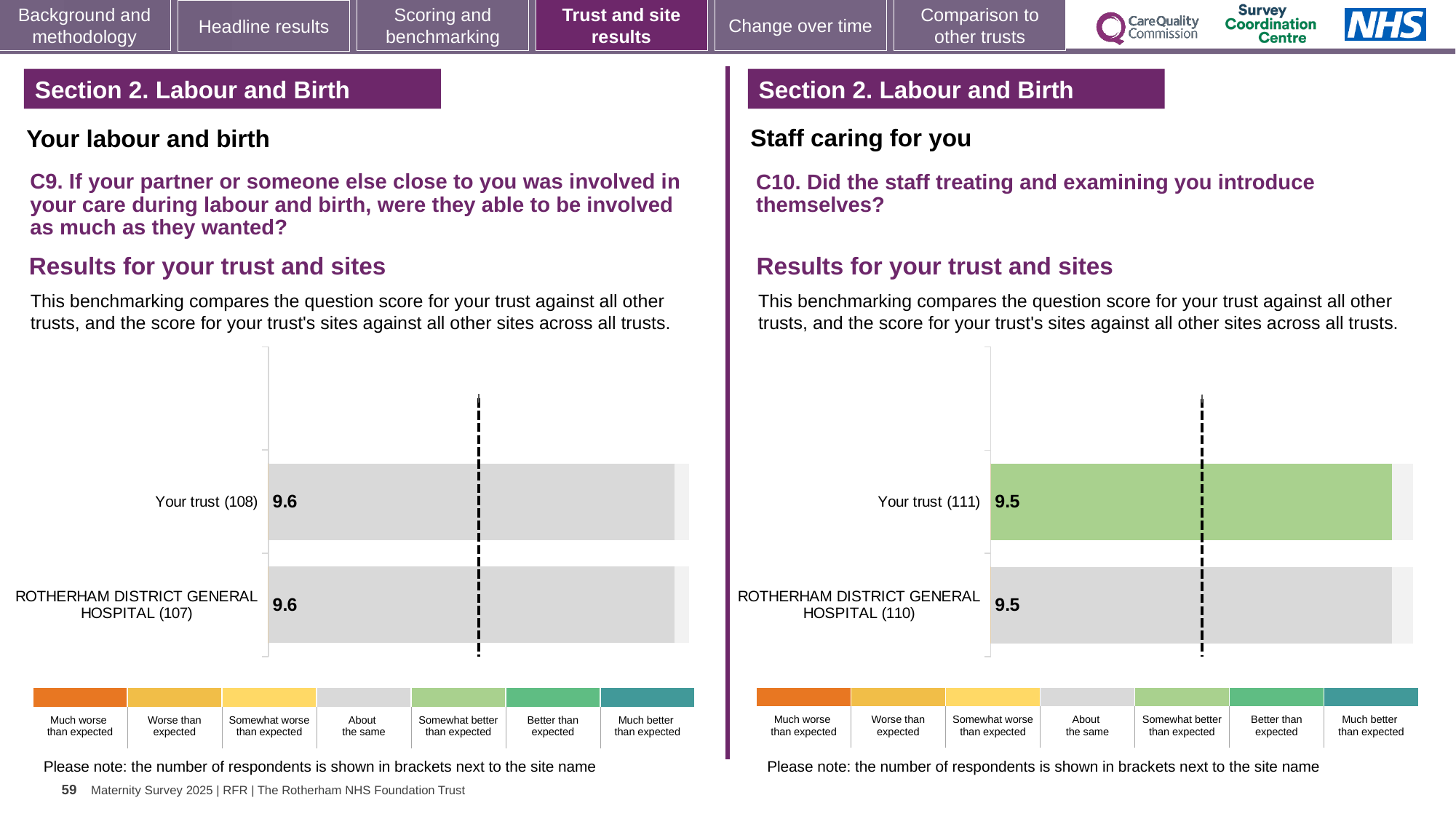
What kind of chart is used in the right chart (C10)? Bar chart How many bars are plotted in the right chart (C10)? 2 In the right chart (C10), which benchmark category does the green colour of the Your trust bar correspond to in the legend? Somewhat better than expected In the left chart (C9), what is the difference between the Your trust score and the ROTHERHAM DISTRICT GENERAL HOSPITAL score? 0.0 In the right chart (C10), how many respondents are shown in brackets for ROTHERHAM DISTRICT GENERAL HOSPITAL? 110 In the left chart (C9), what is the score for ROTHERHAM DISTRICT GENERAL HOSPITAL? 9.6 In the right chart (C10), what is the score for ROTHERHAM DISTRICT GENERAL HOSPITAL? 9.5 In the right chart (C10), what is the difference between the Your trust score and the ROTHERHAM DISTRICT GENERAL HOSPITAL score? 0.0 How many bars are plotted in the left chart (C9)? 2 In the right chart (C10), what is the score for Your trust? 9.5 In the left chart (C9), how many respondents are shown in brackets for Your trust? 108 In the left chart (C9), what is the score for Your trust? 9.6